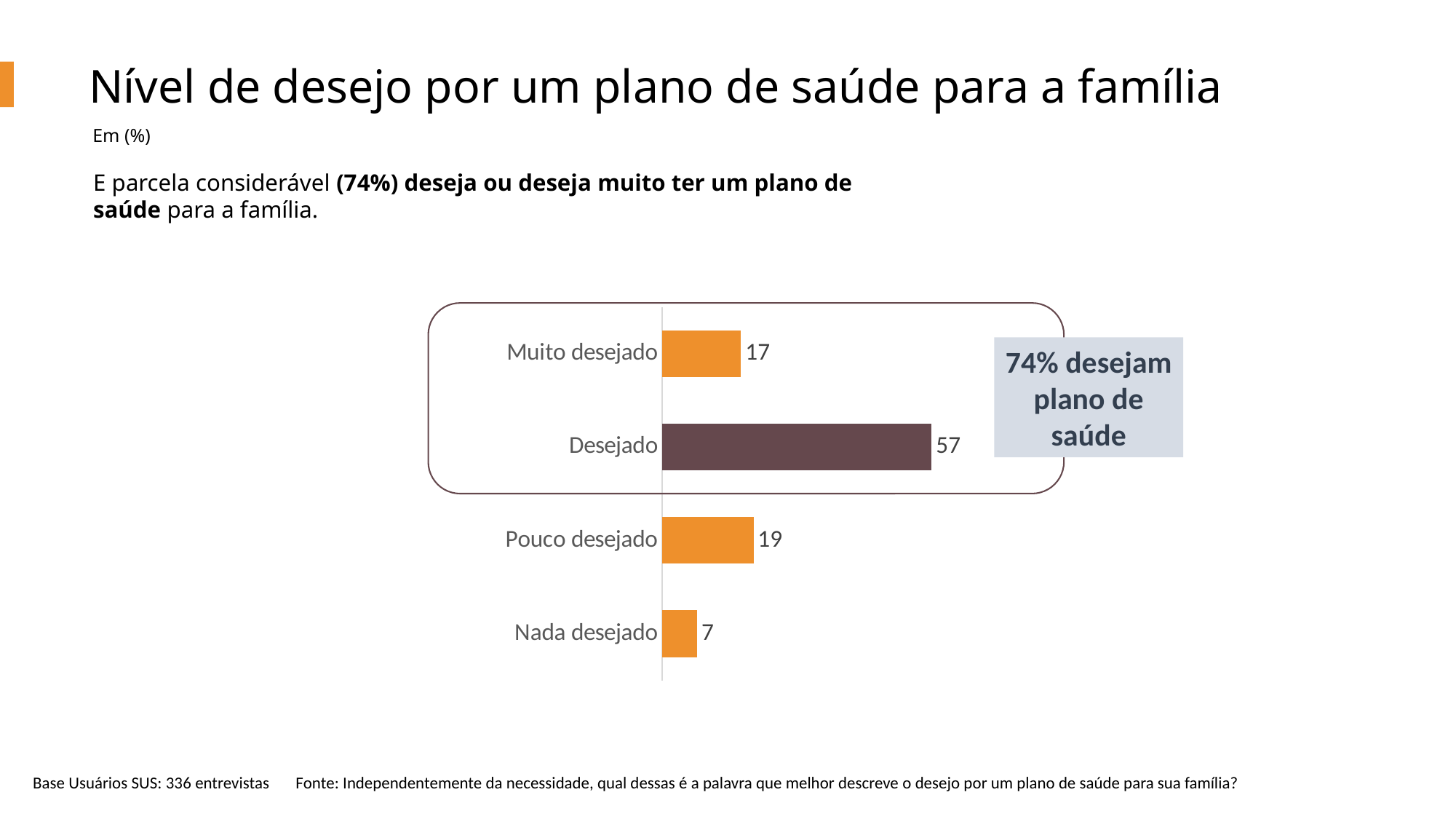
What is the value for Muito desejado? 17 What is the difference between the values for Muito desejado and Nada desejado? 10 Which category has the highest value? Desejado What is the combined value of Muito desejado and Desejado? 74 What is the value for Desejado? 57 Which is larger, the value for Pouco desejado or the value for Muito desejado? Pouco desejado Which category has the lowest value? Nada desejado What is the value for Pouco desejado? 19 What kind of chart is shown on the slide? Bar chart What is the value for Nada desejado? 7 What is the difference between the values for Desejado and Pouco desejado? 38 How many categories are shown in the chart? 4